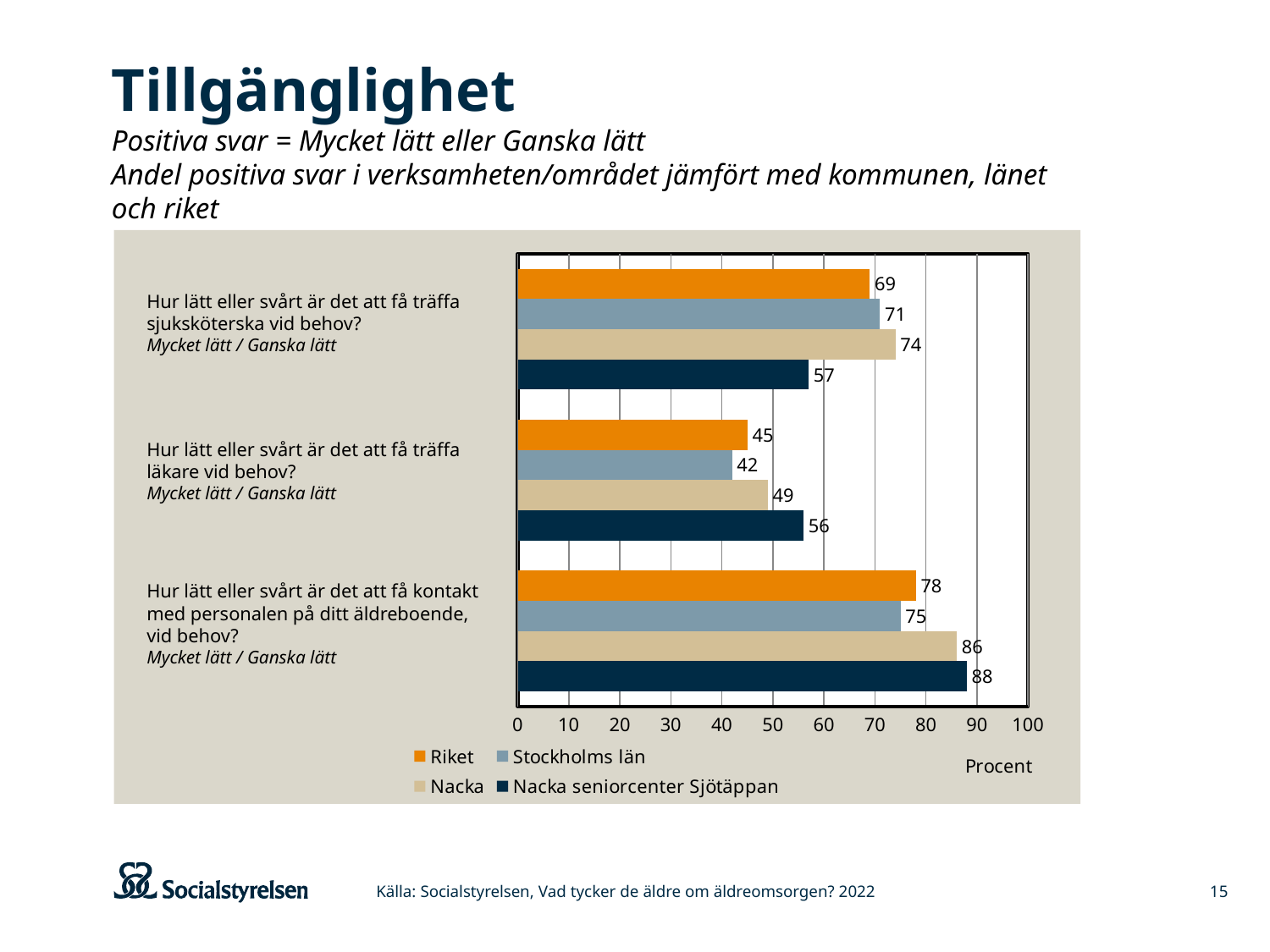
Which series has the highest value for the question about meeting a doctor when needed? Nacka seniorcenter Sjötäppan Which series has the lowest value for the question about meeting a nurse when needed? Nacka seniorcenter Sjötäppan How many question categories are shown on the chart? 3 How many series does the legend list? 4 What is the value for Nacka seniorcenter Sjötäppan for the question about getting in contact with staff at the care home ("Hur lätt eller svårt är det att få kontakt med personalen på ditt äldreboende, vid behov?")? 88 What is the value for Stockholms län for the question about meeting a nurse when needed ("Hur lätt eller svårt är det att få träffa sjuksköterska vid behov?")? 71 What is the label of the x axis on the chart? Procent For the question about meeting a nurse when needed, which is larger: the value for Nacka or the value for Nacka seniorcenter Sjötäppan? Nacka What kind of chart is shown on the slide? Bar chart What is the value for Riket for the question about meeting a doctor when needed ("Hur lätt eller svårt är det att få träffa läkare vid behov?")? 45 Is the value for Stockholms län for the question about meeting a doctor when needed greater or less than 50? less What is the difference between the Nacka value and the Riket value for the question about getting in contact with staff at the care home? 8